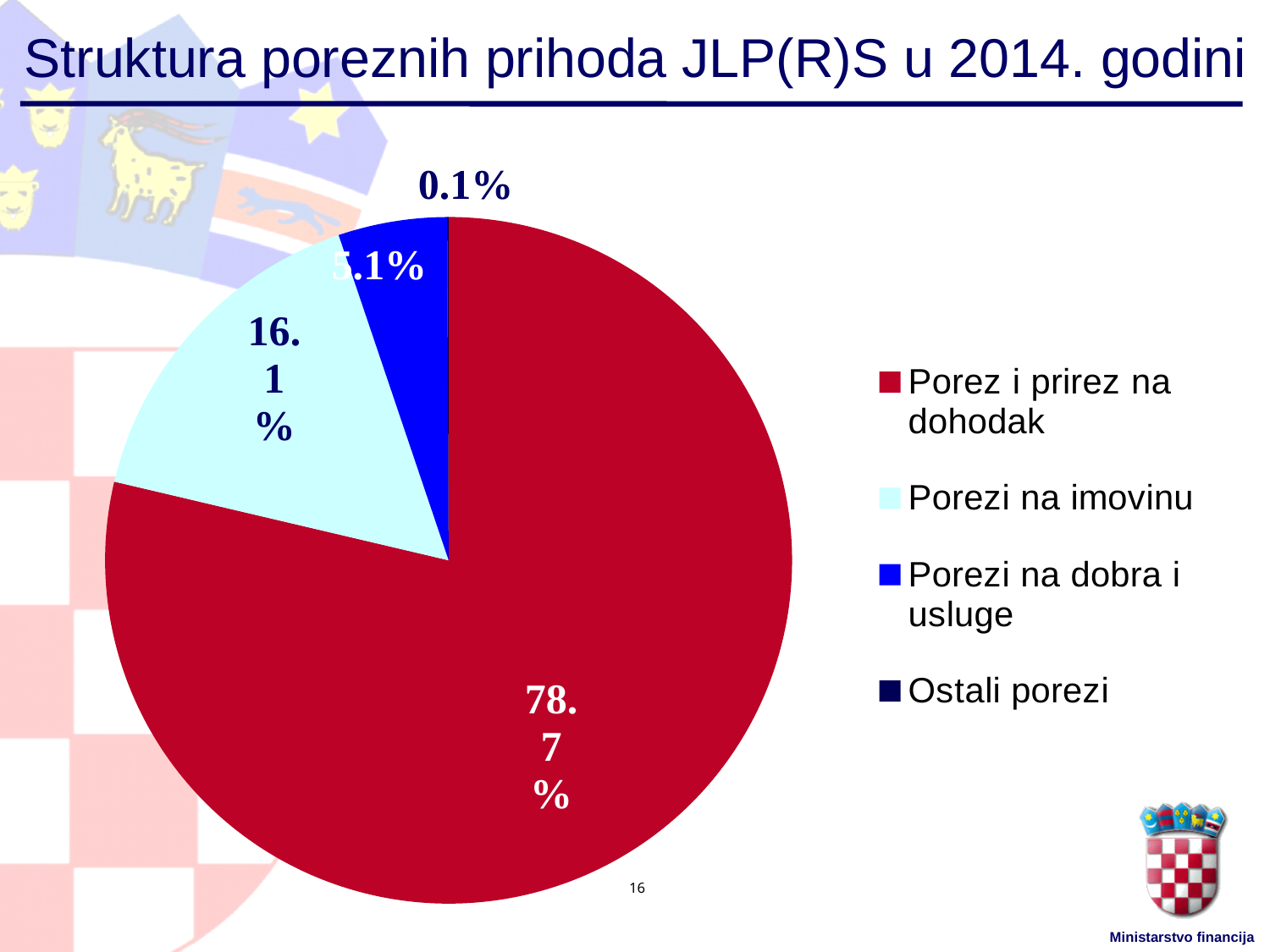
What is the value shown for Porezi na dobra i usluge? 5.1% Which legend entry is shown in light blue? Porezi na imovinu Which is larger, the share for Porezi na imovinu or the share for Porezi na dobra i usluge? Porezi na imovinu Which category has the smallest slice of the pie? Ostali porezi Which category has the largest slice of the pie? Porez i prirez na dohodak What share of the pie does Porez i prirez na dohodak have? 78.7% What is the value shown for Ostali porezi? 0.1% What is the value shown for Porezi na imovinu? 16.1% What is the title of the chart on the slide? Struktura poreznih prihoda JLP(R)S u 2014. godini How many categories does the pie chart show? 4 What kind of chart is shown on the slide? Pie chart What is the difference between the shares of Porez i prirez na dohodak and Porezi na imovinu? 62.6 percentage points